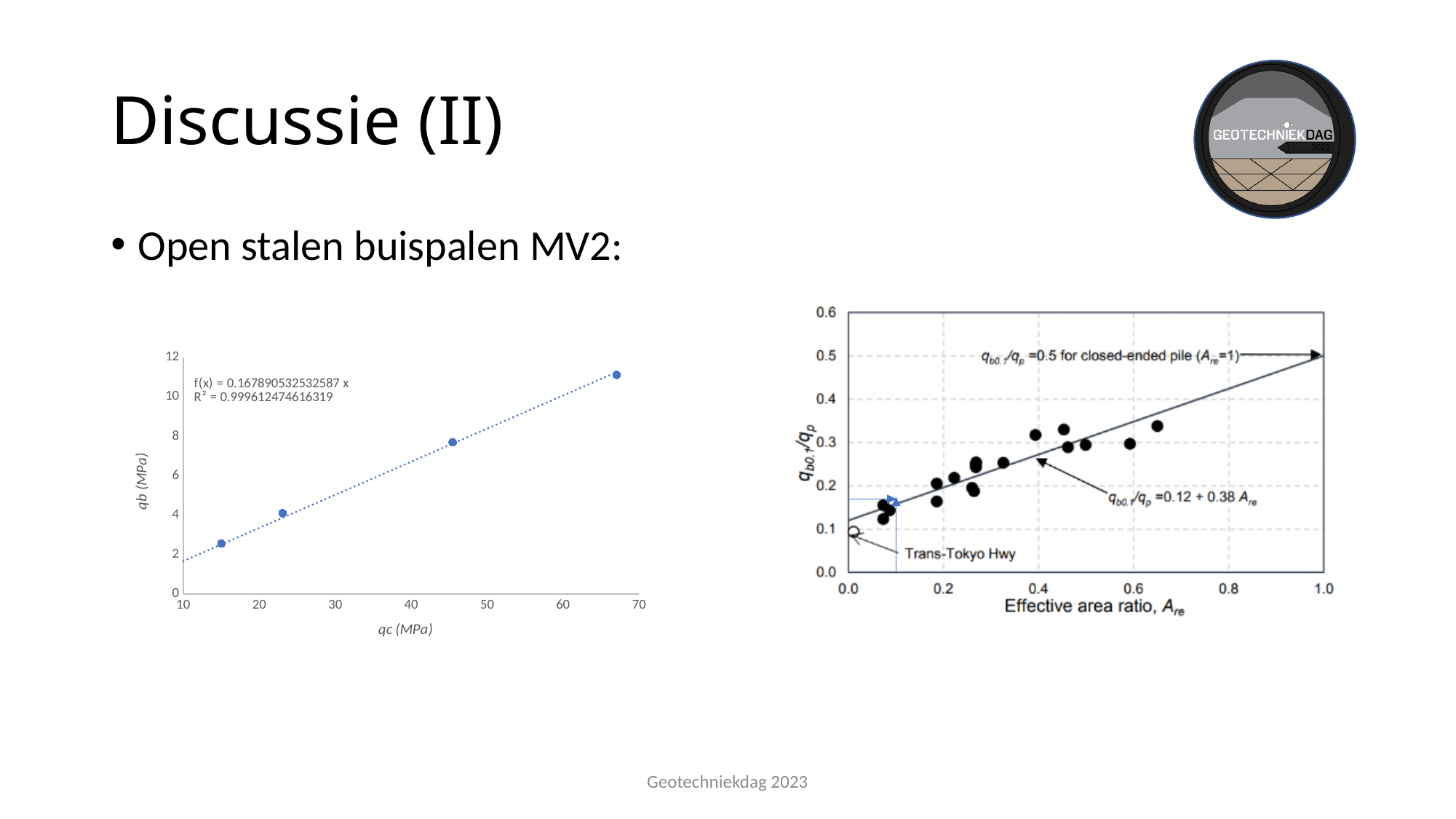
How many data points are plotted on the left chart (qb versus qc)? 4 On the right chart, what equation is given for the fitted line? q_b0.1/q_p = 0.12 + 0.38 A_re On the left chart (qb versus qc), do the qb values rise or fall as qc increases? rise On the left chart (qb versus qc), is the qb value of the leftmost point (near qc = 15 MPa) greater or less than 4? less What is the label of the x axis on the left chart? qc (MPa) What kind of chart is the left chart (qb versus qc)? scatter chart On the left chart (qb versus qc), is the qb value of the point near qc = 45 MPa greater or less than 6? greater On the right chart, is the q_b0.1/q_p value of the rightmost point (near A_re = 0.65) greater or less than 0.3? greater On the right chart, according to the annotation, what is q_b0.1/q_p for a closed-ended pile (A_re = 1)? 0.5 What kind of chart is the right chart (q_b0.1/q_p versus effective area ratio)? scatter chart On the right chart, do the q_b0.1/q_p values rise or fall as the effective area ratio A_re increases? rise